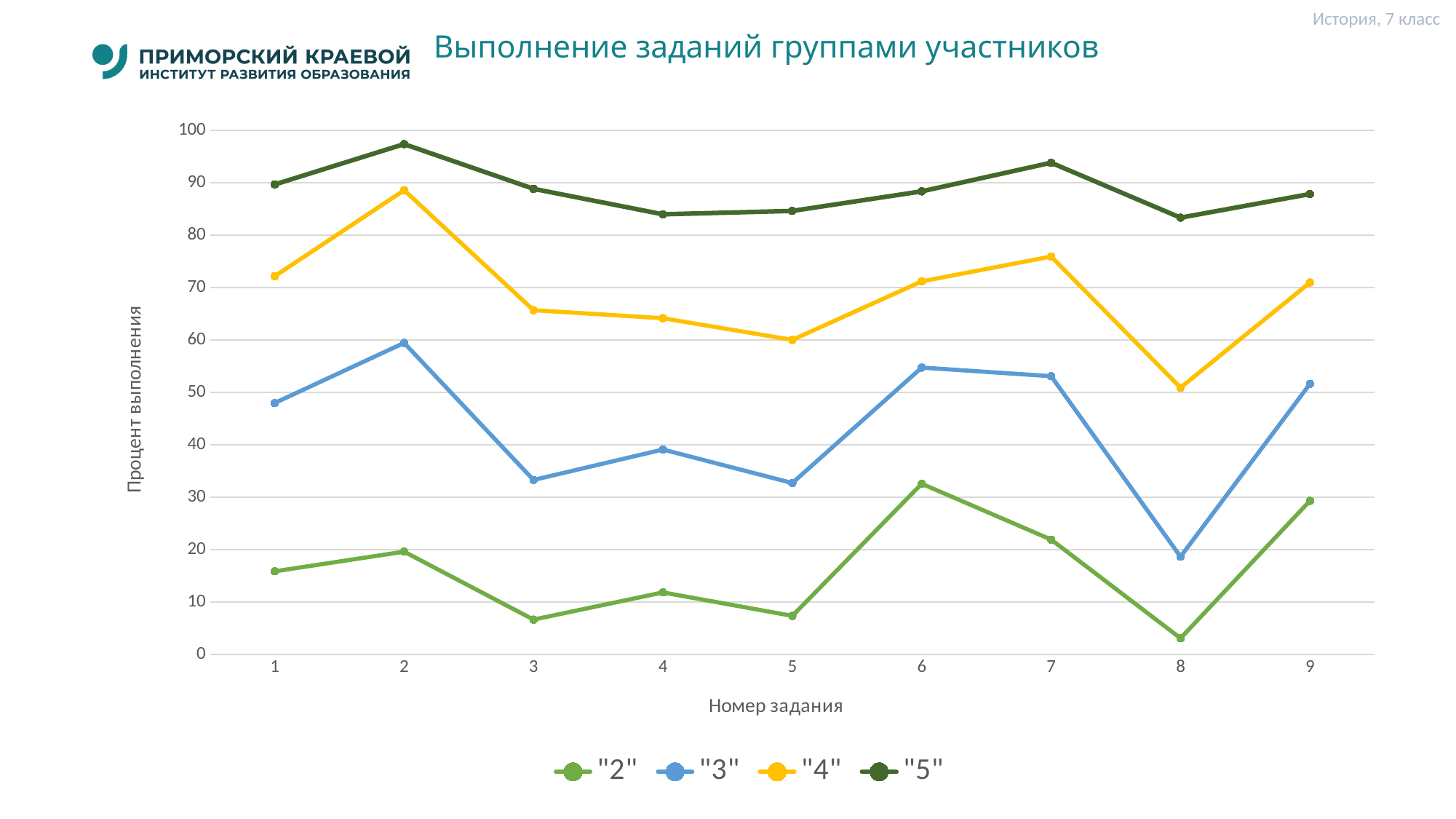
For which task number does the "2" series reach its lowest value? 8 Is the value of the "3" series for task 8 greater or less than 20? less Is the value of the "4" series for task 2 greater or less than 80? greater For which task number does the "4" series reach its lowest value? 8 How many task numbers are shown on the x axis? 9 For which task number does the "5" series reach its highest value? 2 Does the "3" series rise or fall from task 7 to task 8? fall What is the title of the y axis? Процент выполнения What kind of chart is shown on the slide? line chart For which task number does the "2" series reach its highest value? 6 Which is larger for the "2" series: the value for task 6 or the value for task 7? task 6 How many series does the legend list? 4